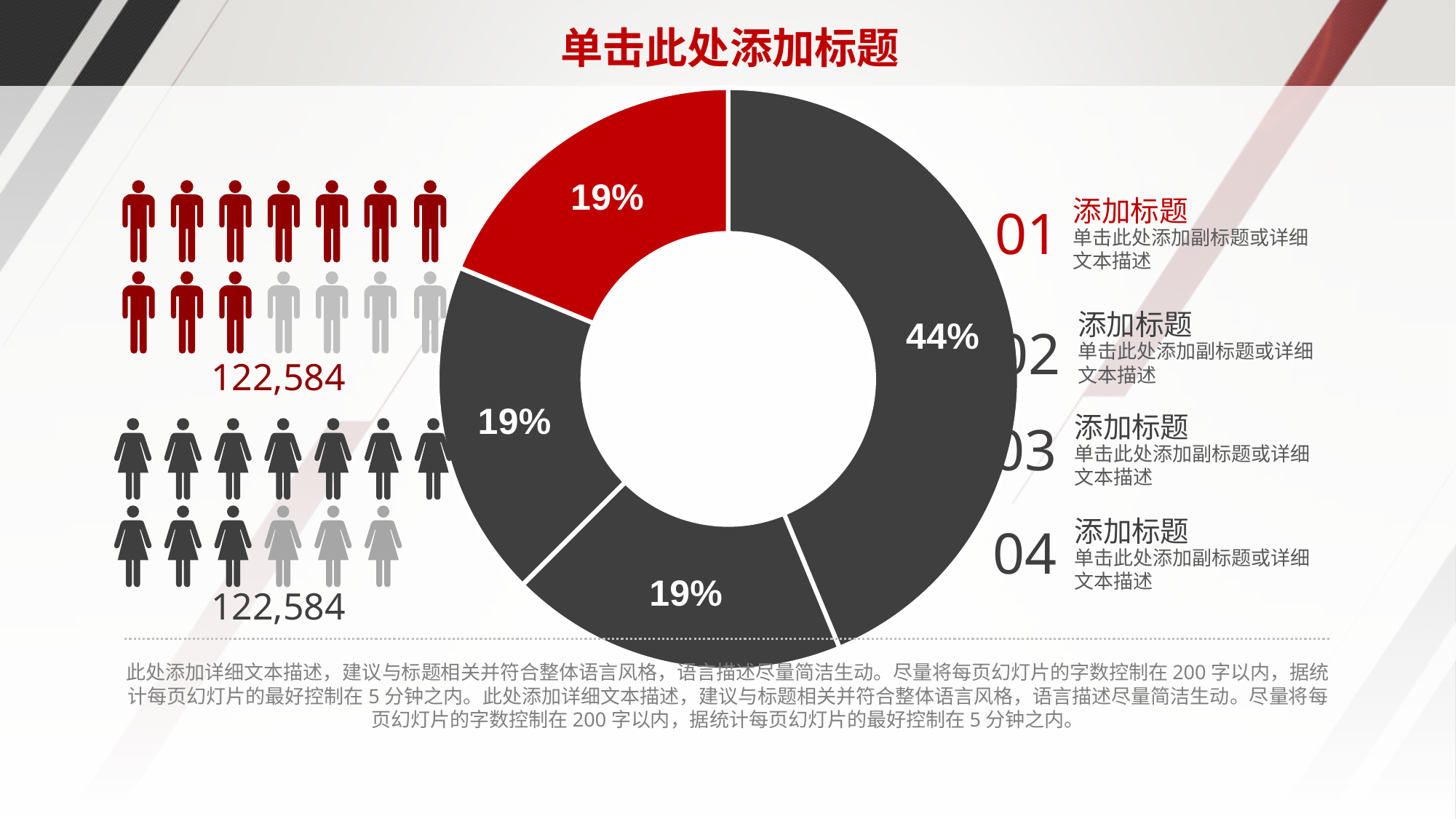
What colour is the slice labelled 19% at the top-left of the donut chart? red What is the smallest value labelled on the donut chart? 19% What number is printed below the row of male figures in the pictogram on the left? 122,584 What is the title shown above the donut chart? 单击此处添加标题 Is the share of the red slice in the donut chart greater or less than 25%? less How many slices of the donut chart are labelled 19%? 3 What is the value of the largest slice in the donut chart? 44% What is the difference between the largest slice (44%) and the red slice (19%) in the donut chart? 25 percentage points How many slices does the donut chart have? 4 What kind of chart is shown in the centre of the slide? donut (pie) chart Which is larger in the donut chart: the red slice or the large dark grey slice on the right? the dark grey slice on the right (44%) What value is labelled on the red slice of the donut chart? 19%